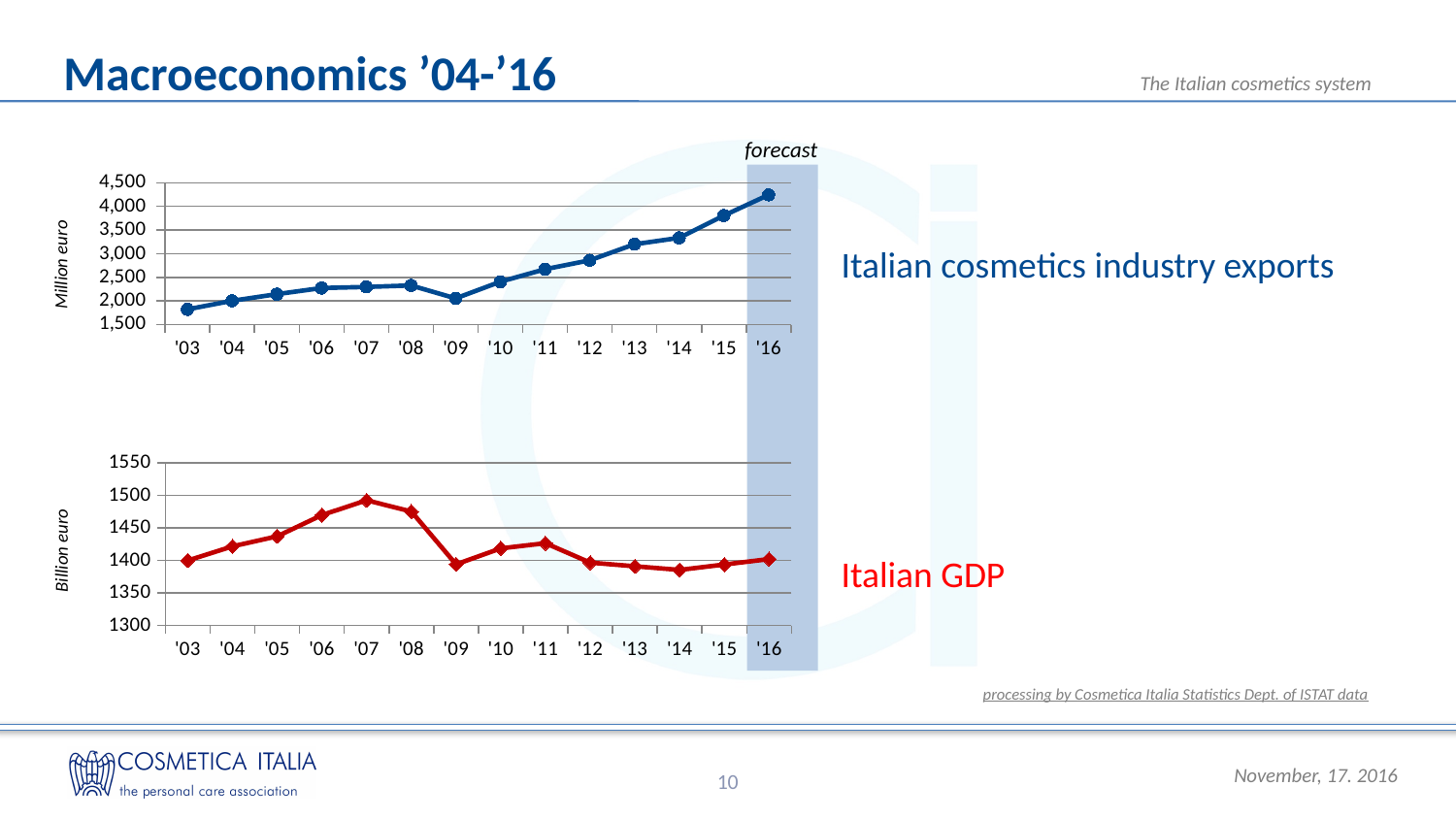
What unit is shown on the y axis of the Italian GDP chart? Billion euro What kind of chart is the bottom chart (Italian GDP)? line chart In the Italian cosmetics industry exports chart, do the values generally rise or fall from '09 to '16? rise In the Italian cosmetics industry exports chart, which year has the highest value? '16 What kind of chart is the top chart (Italian cosmetics industry exports)? line chart In the Italian GDP chart, is the value for '06 greater or less than 1450? greater In the Italian cosmetics industry exports chart, which year has the lowest value? '03 In the Italian cosmetics industry exports chart, is the value for '16 greater or less than 4,000? greater In the Italian GDP chart, which is larger, the value for '07 or the value for '09? '07 In the Italian cosmetics industry exports chart, how many years are plotted on the x axis? 14 In the Italian cosmetics industry exports chart, is the value for '15 greater or less than 3,500? greater In the Italian GDP chart, which year has the highest value? '07